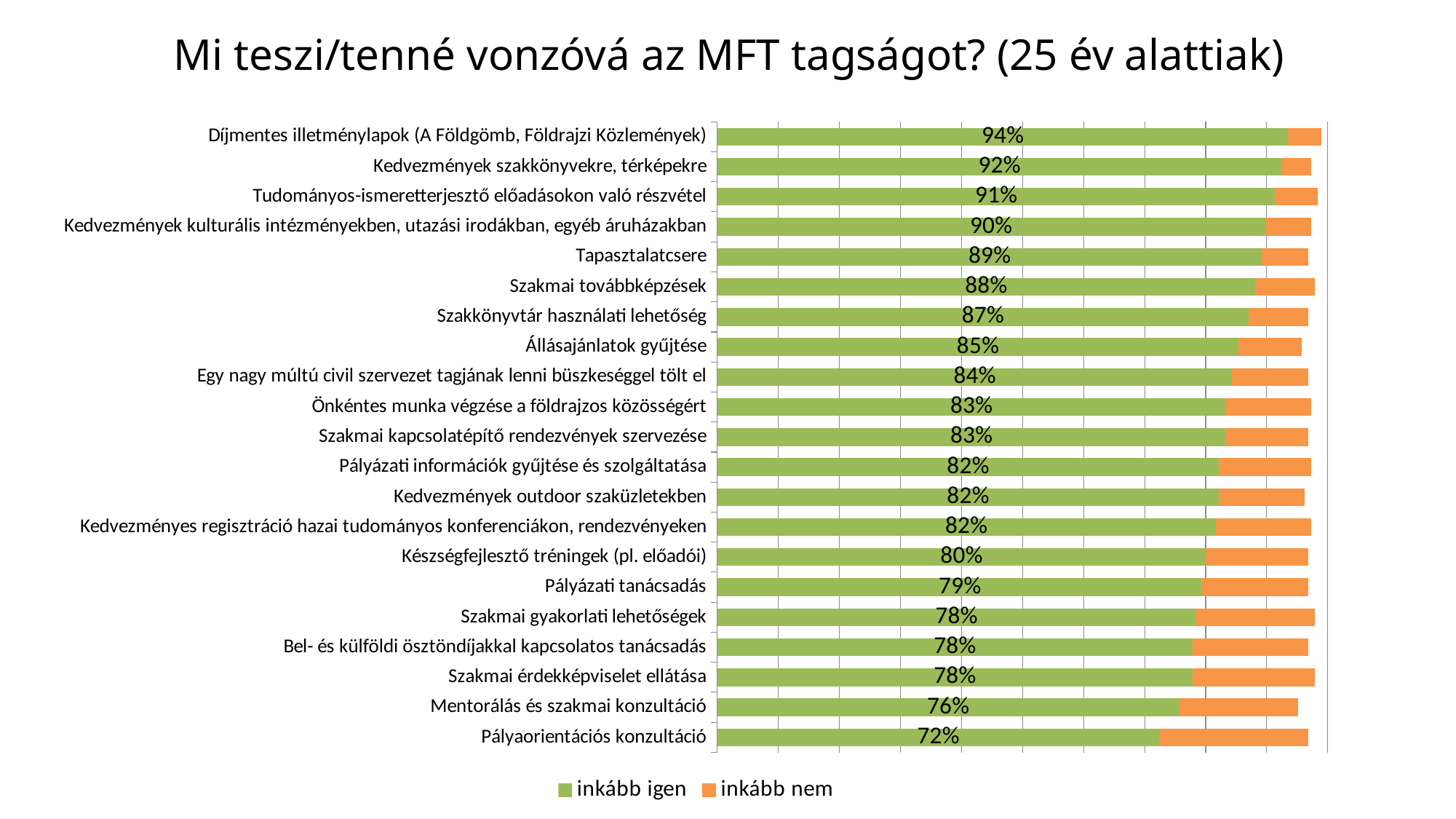
Which category has the highest "inkább igen" value? Díjmentes illetménylapok (A Földgömb, Földrajzi Közlemények) What is the "inkább igen" value for Mentorálás és szakmai konzultáció? 76% How many series does the legend list? 2 What is the "inkább igen" value for Tapasztalatcsere? 89% What is the difference between the "inkább igen" values for Díjmentes illetménylapok and Pályaorientációs konzultáció? 22% Which category has the lowest "inkább igen" value? Pályaorientációs konzultáció What is the "inkább igen" value for Készségfejlesztő tréningek (pl. előadói)? 80% How many categories are shown in the chart? 21 Which has a higher "inkább igen" value: Pályázati tanácsadás or Szakmai továbbképzések? Szakmai továbbképzések What is the difference between the "inkább igen" values for Szakkönyvtár használati lehetőség and Állásajánlatok gyűjtése? 2% What kind of chart is shown on the slide? Stacked bar chart Which colour represents the "inkább nem" series? Orange